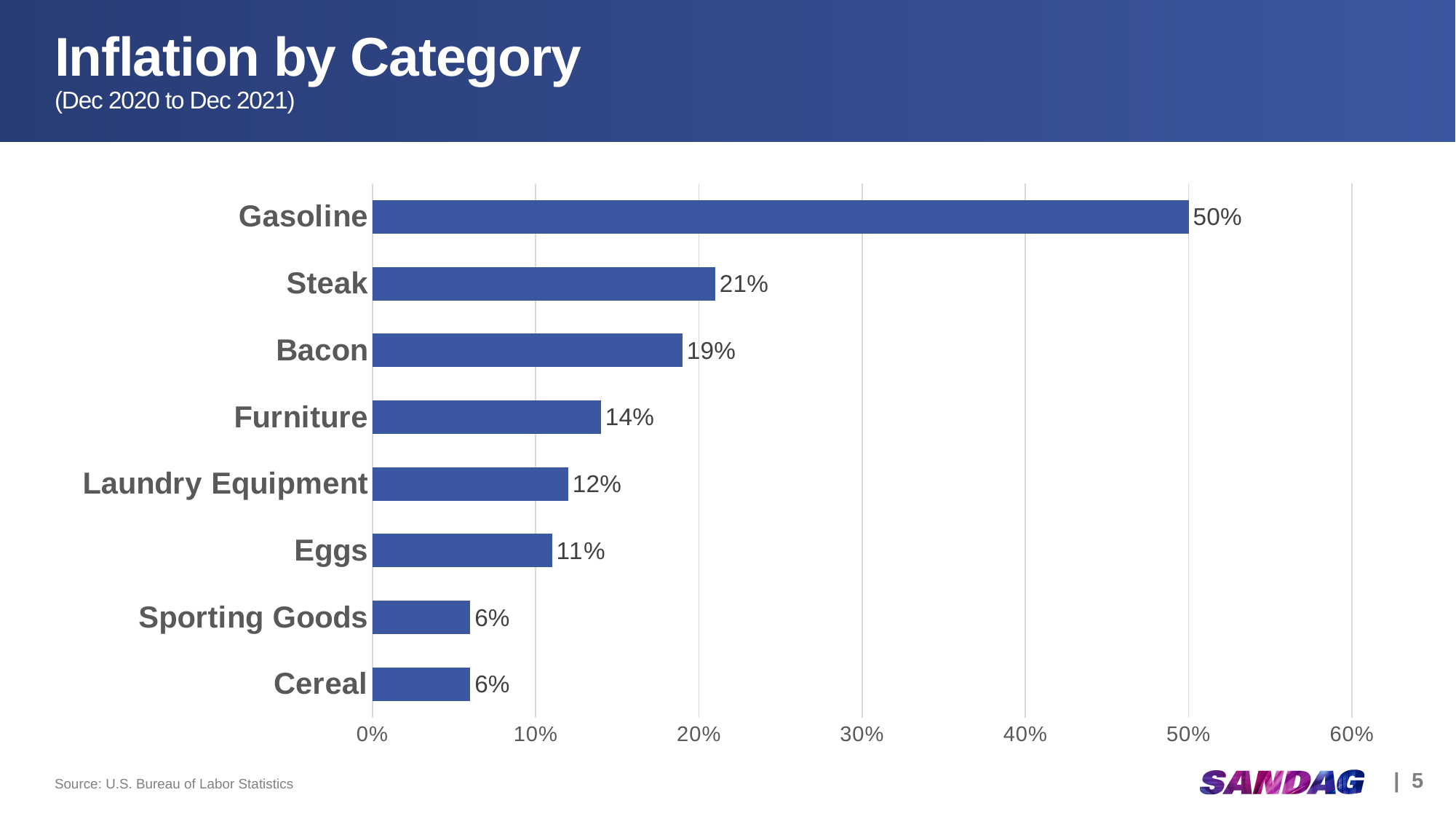
What is the title of the chart on the slide? Inflation by Category What is the inflation value for Eggs? 11% Is the inflation value for Bacon greater or less than 10%? greater How many categories are shown in the chart? 8 What is the inflation value for Gasoline? 50% What is the difference between the inflation values for Gasoline and Furniture? 36% What is the inflation value for Laundry Equipment? 12% Which category has the highest inflation? Gasoline Which has a higher inflation value, Furniture or Eggs? Furniture What time period does the chart cover, according to the subtitle? Dec 2020 to Dec 2021 What is the difference between the inflation values for Steak and Bacon? 2% What kind of chart is shown on the slide? Bar chart